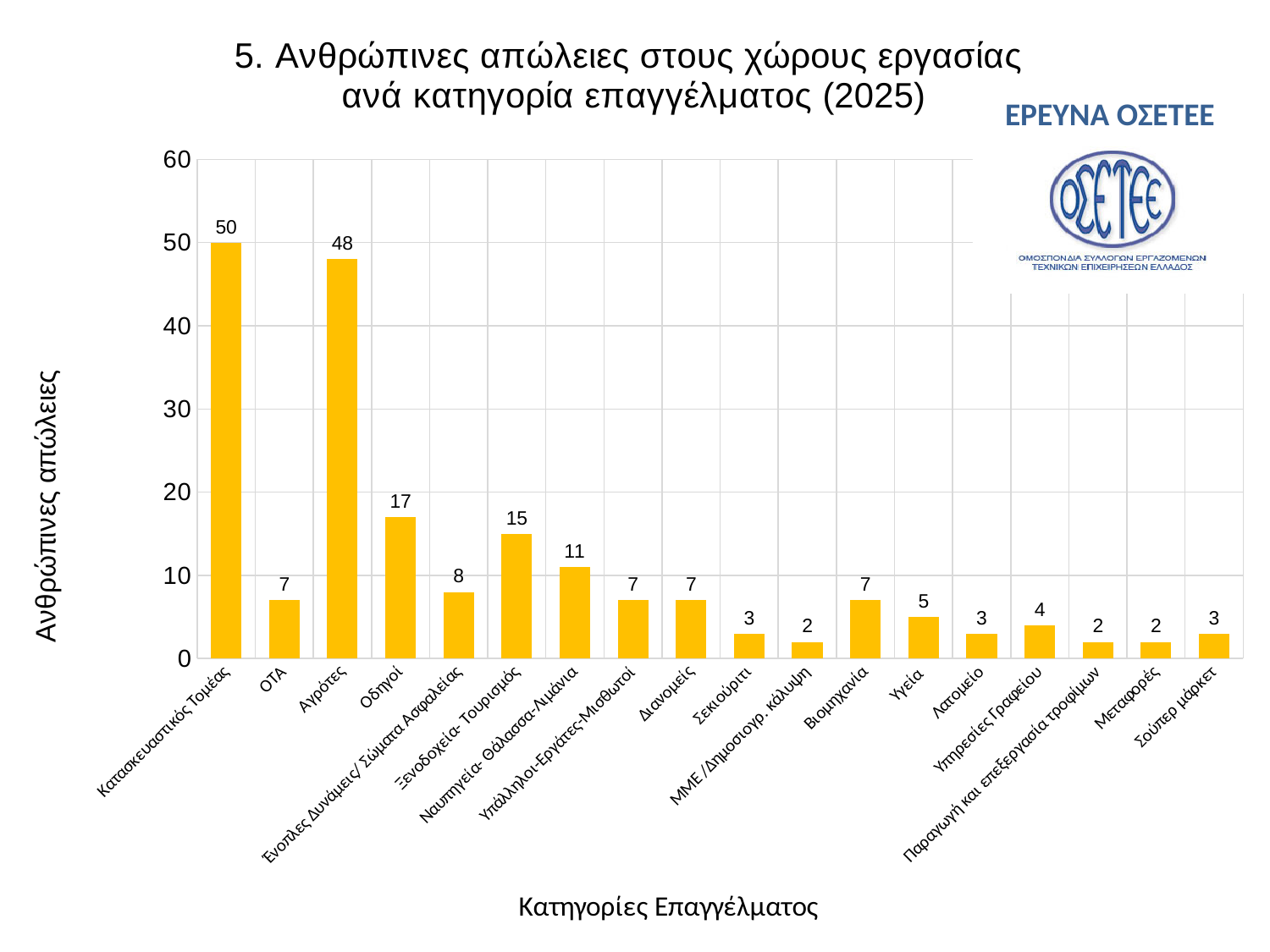
What is the value for Ξενοδοχεία- Τουρισμός? 15 What is the label of the horizontal axis? Κατηγορίες Επαγγέλματος Which category has the highest number of fatalities? Κατασκευαστικός Τομέας What is the value for Αγρότες? 48 What is the value for Ναυπηγεία- Θάλασσα-Λιμάνια? 11 What type of chart is shown on the slide? Bar chart How many occupation categories are plotted on the chart? 18 What is the label of the vertical axis? Ανθρώπινες απώλειες What is the value for Οδηγοί? 17 Which is larger, the value for Οδηγοί or the value for Ξενοδοχεία- Τουρισμός? Οδηγοί What is the difference between the values for Υγεία and Υπηρεσίες Γραφείου? 1 What is the difference between the values for Κατασκευαστικός Τομέας and Αγρότες? 2